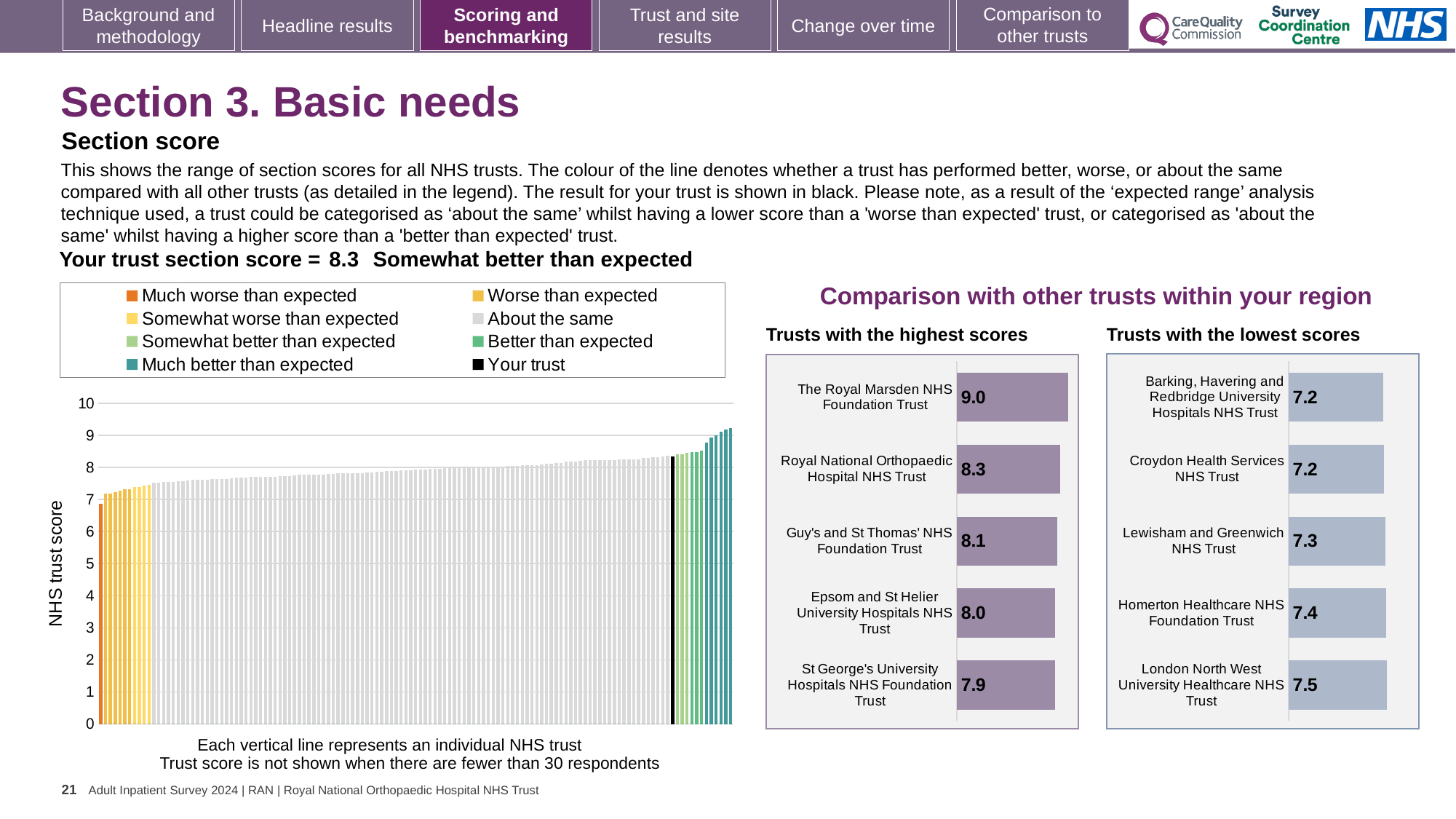
What is the y-axis label of the large chart on the left? NHS trust score In the 'Trusts with the highest scores' chart, which trust has the highest score? The Royal Marsden NHS Foundation Trust In the 'Trusts with the highest scores' chart, what is the score for The Royal Marsden NHS Foundation Trust? 9.0 How many trusts are shown in the 'Trusts with the highest scores' chart? 5 In the large chart on the left, is the value for the black bar (your trust) greater or less than 8? greater How many entries does the legend of the large chart on the left list? 8 In the 'Trusts with the highest scores' chart, what is the difference between the scores of The Royal Marsden NHS Foundation Trust and St George's University Hospitals NHS Foundation Trust? 1.1 In the 'Trusts with the lowest scores' chart, what is the score for Homerton Healthcare NHS Foundation Trust? 7.4 In the 'Trusts with the lowest scores' chart, which trust has the highest score? London North West University Healthcare NHS Trust In the 'Trusts with the lowest scores' chart, which has the larger score: Croydon Health Services NHS Trust or Lewisham and Greenwich NHS Trust? Lewisham and Greenwich NHS Trust In the 'Trusts with the highest scores' chart, which has the larger score: Guy's and St Thomas' NHS Foundation Trust or Epsom and St Helier University Hospitals NHS Trust? Guy's and St Thomas' NHS Foundation Trust What kind of chart is the 'Trusts with the lowest scores' chart? Bar chart